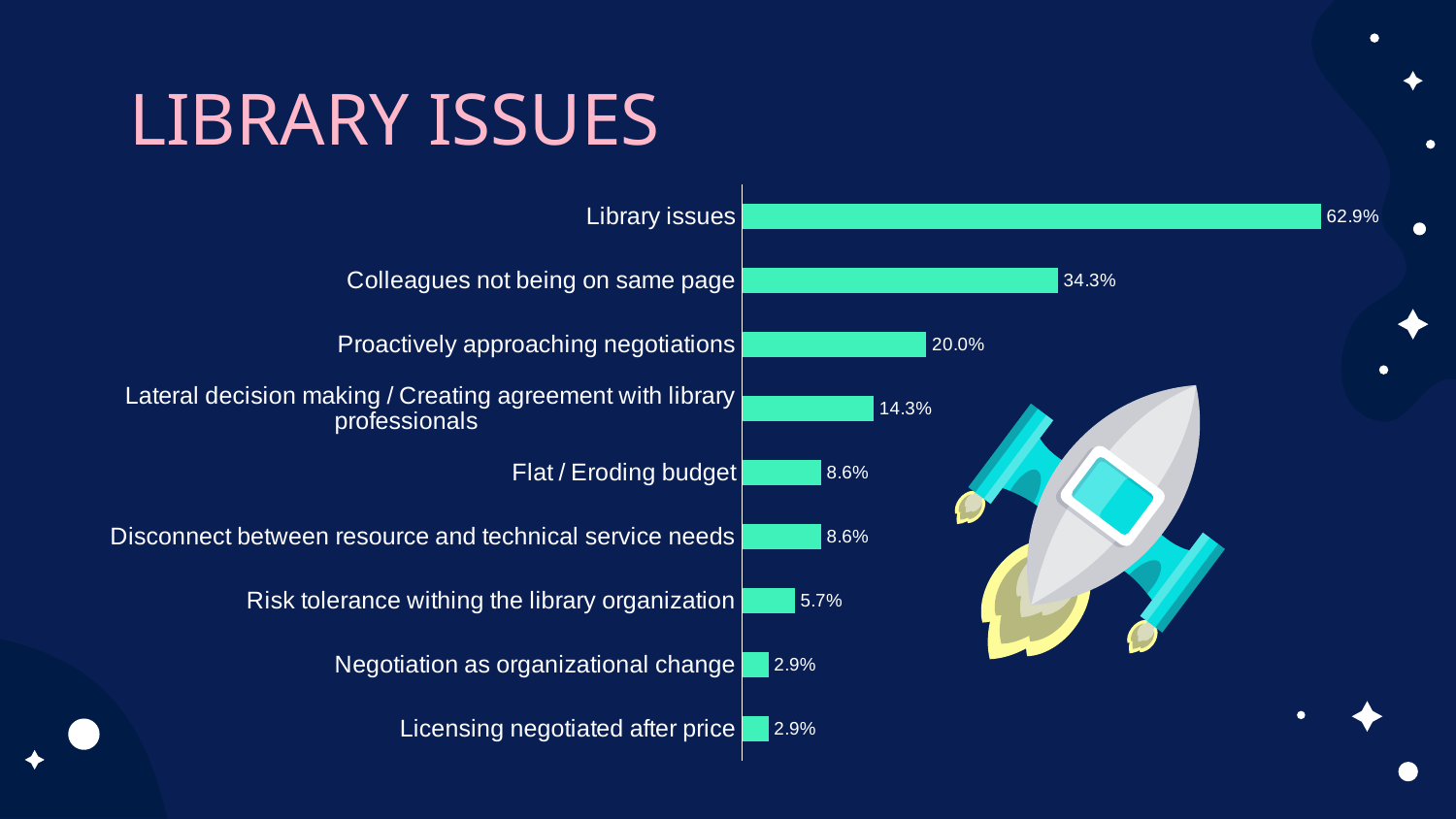
What is the value for Library issues? 62.9% What kind of chart is shown on the slide? Bar chart How many categories are shown in the chart? 9 Which category has the highest value? Library issues Do the bar values increase or decrease from the top of the chart to the bottom? Decrease What is the difference between the values for Proactively approaching negotiations and Lateral decision making / Creating agreement with library professionals? 5.7 percentage points What is the value for Lateral decision making / Creating agreement with library professionals? 14.3% What is the value for Proactively approaching negotiations? 20.0% What is the value for Risk tolerance withing the library organization? 5.7% What is the difference between the values for Library issues and Colleagues not being on same page? 28.6 percentage points Which is larger, the value for Flat / Eroding budget or the value for Risk tolerance withing the library organization? Flat / Eroding budget What is the value for Colleagues not being on same page? 34.3%